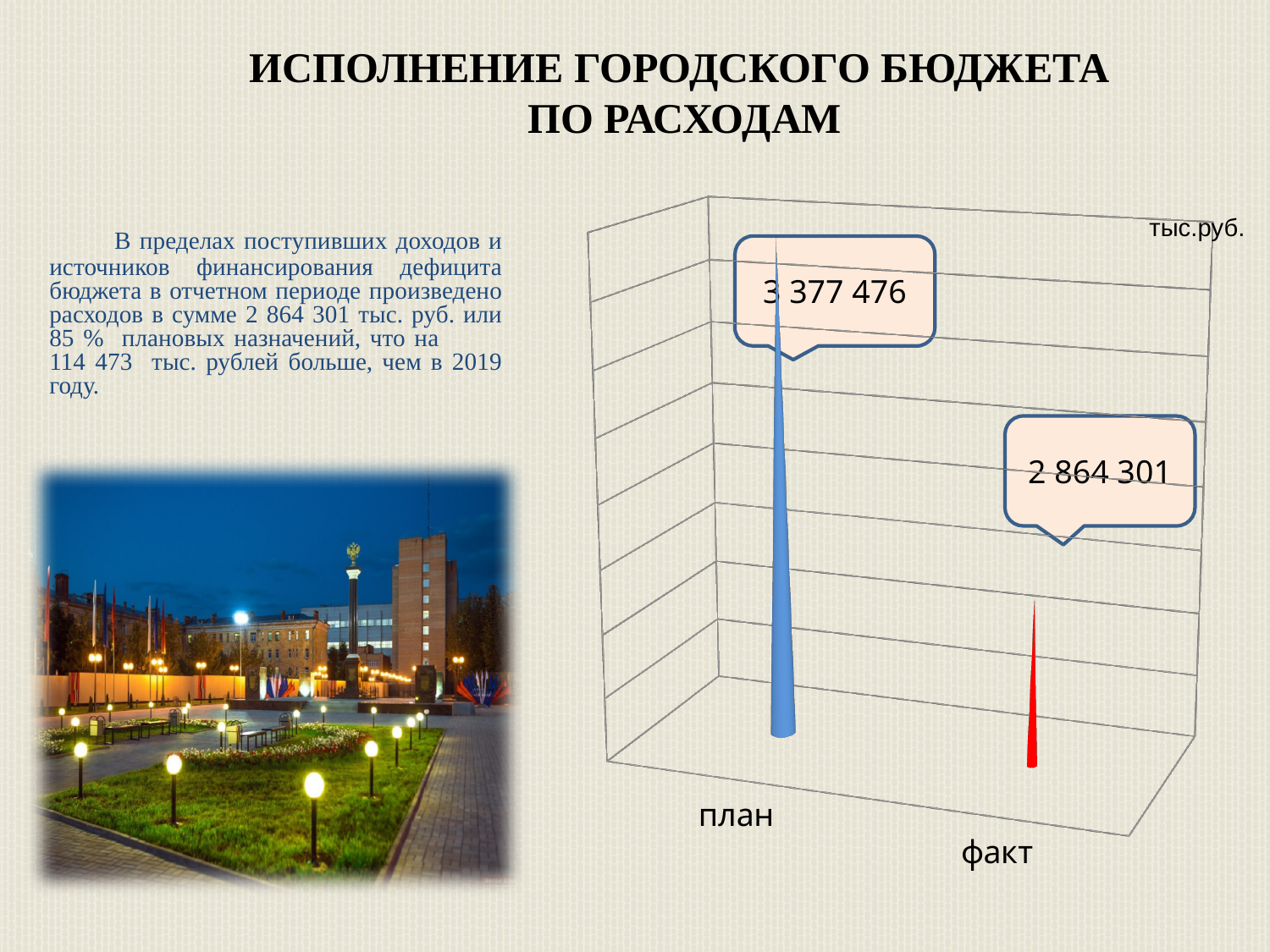
What is the difference between the план and факт values? 513 175 Which category has the lowest value on the chart? факт Which category has the higher value, план or факт? план Do the values fall or rise going from план to факт? fall Which category has the highest value on the chart? план What kind of chart is shown on the slide? bar chart What is the value for факт on the chart? 2 864 301 What unit is indicated for the values on the chart? тыс.руб. What colour is the bar for факт? red What is the value for план on the chart? 3 377 476 How many categories are plotted on the chart? 2